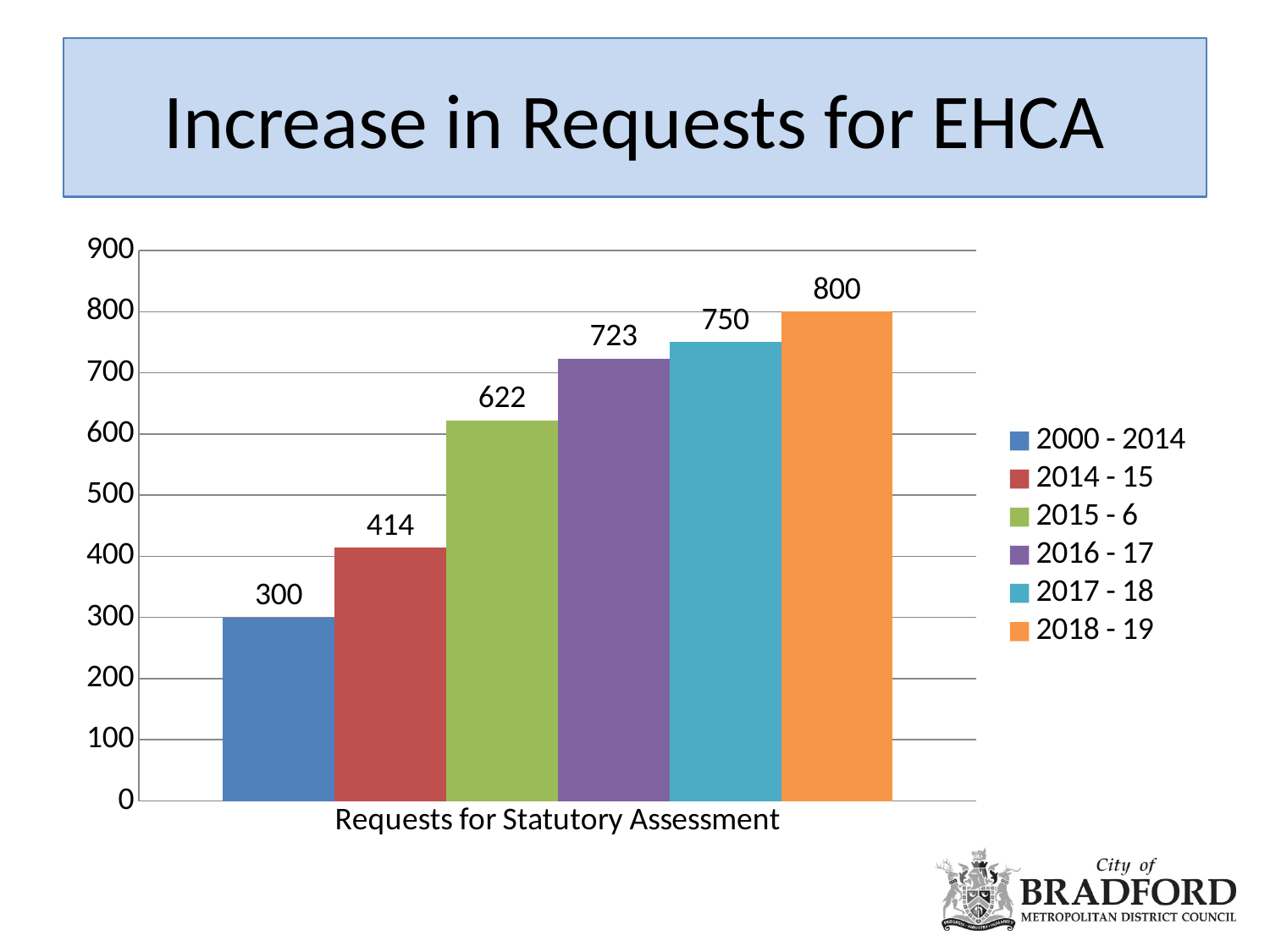
What is the difference between the values for 2018 - 19 and 2000 - 2014? 500 What is the value for 2018 - 19? 800 What is the difference between the values for 2015 - 6 and 2014 - 15? 208 What is the value for 2016 - 17? 723 Which series has the highest value? 2018 - 19 How many series does the legend list? 6 What is the value for 2000 - 2014? 300 What kind of chart is shown on the slide? bar chart Which is larger, the value for 2017 - 18 or the value for 2016 - 17? 2017 - 18 Which series has the lowest value? 2000 - 2014 Do the values rise or fall from 2000 - 2014 to 2018 - 19? rise What is the label shown on the x axis of the chart? Requests for Statutory Assessment